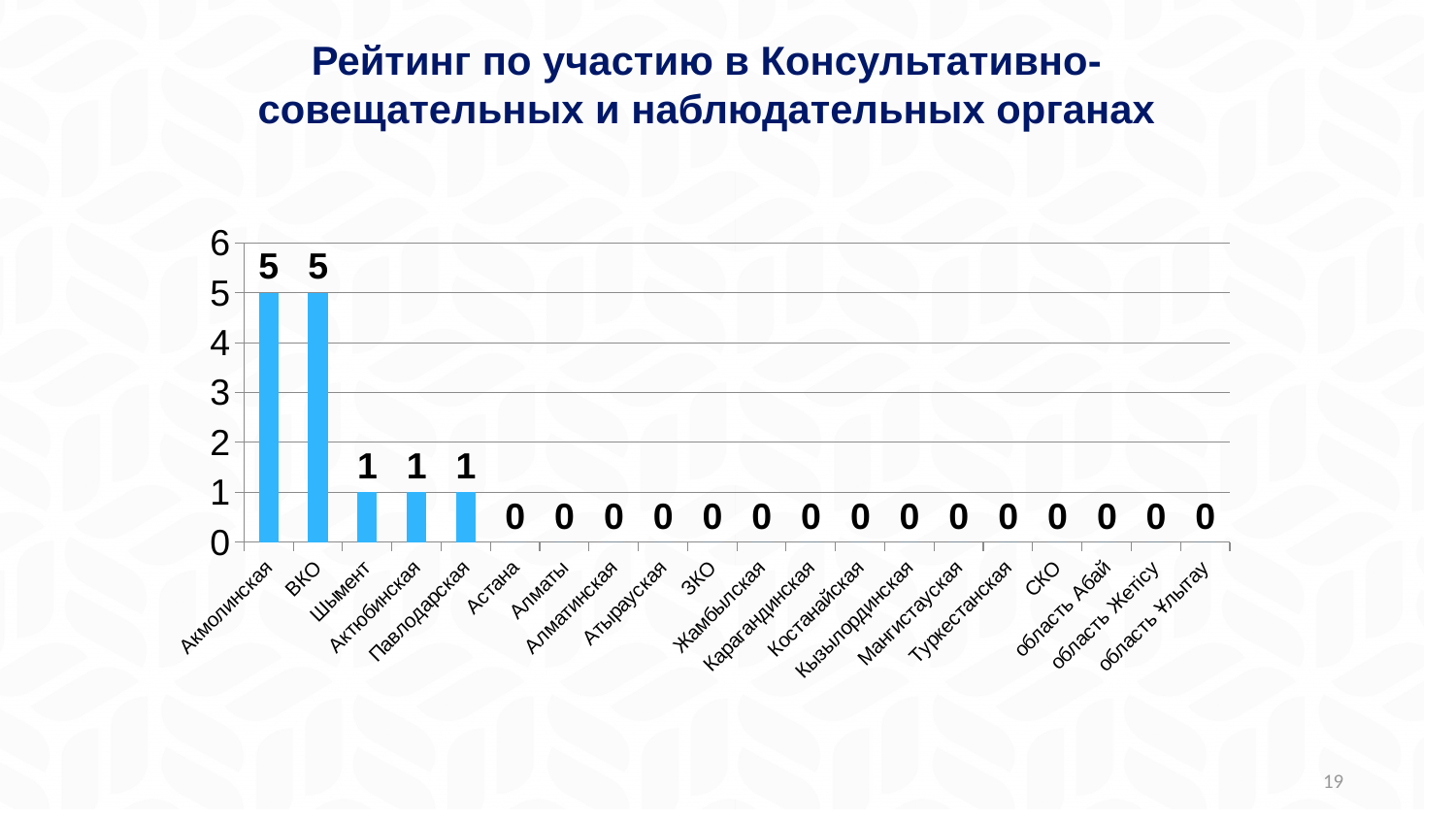
What kind of chart is shown on the slide? Bar chart What is the difference between the values for Акмолинская and Актюбинская? 4 What is the value for область Абай? 0 What is the value for Акмолинская? 5 What is the value for Павлодарская? 1 What is the value for Астана? 0 Which is larger, the value for Актюбинская or the value for Алматы? Актюбинская Which is larger, the value for ВКО or the value for Шымкент? ВКО What is the value for ВКО? 5 What is the value for Шымкент? 1 How many categories are shown on the x axis? 20 What is the title of the chart? Рейтинг по участию в Консультативно-совещательных и наблюдательных органах